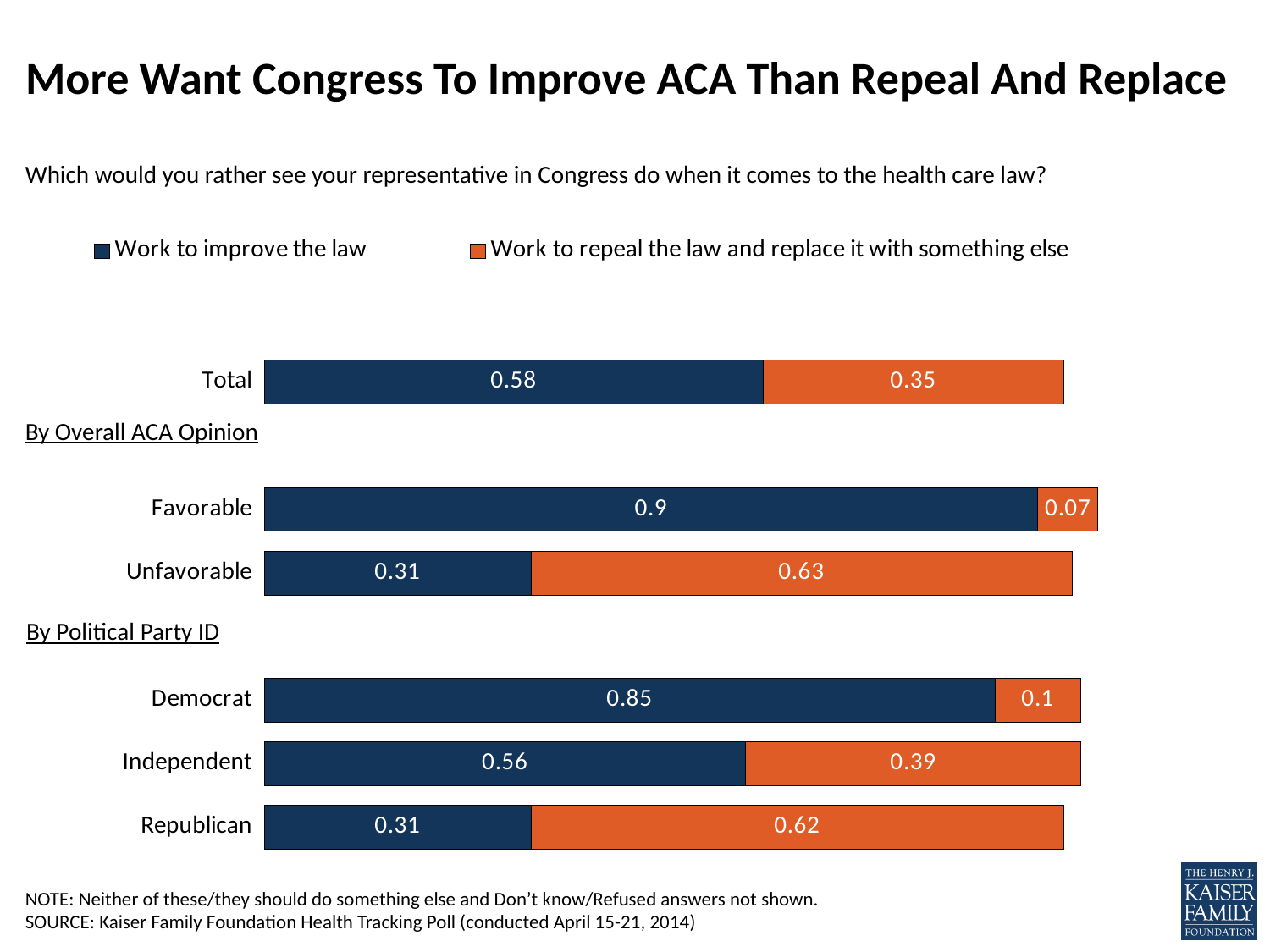
What is the difference between the "Work to improve the law" values for Democrat and Republican? 0.54 What colour represents "Work to repeal the law and replace it with something else" in the chart? Orange How many categories are plotted in the chart? 6 Which category has the lowest value for "Work to repeal the law and replace it with something else"? Favorable How many series does the legend list? 2 What is the value for "Work to repeal the law and replace it with something else" for Unfavorable? 0.63 Which is larger for Independent: "Work to improve the law" or "Work to repeal the law and replace it with something else"? Work to improve the law Which category has the highest value for "Work to improve the law"? Favorable What is the value for "Work to improve the law" for Independent? 0.56 What is the total of the stacked bar for Republican? 0.93 What is the value for "Work to improve the law" for Total? 0.58 What kind of chart is shown on the slide? Stacked bar chart